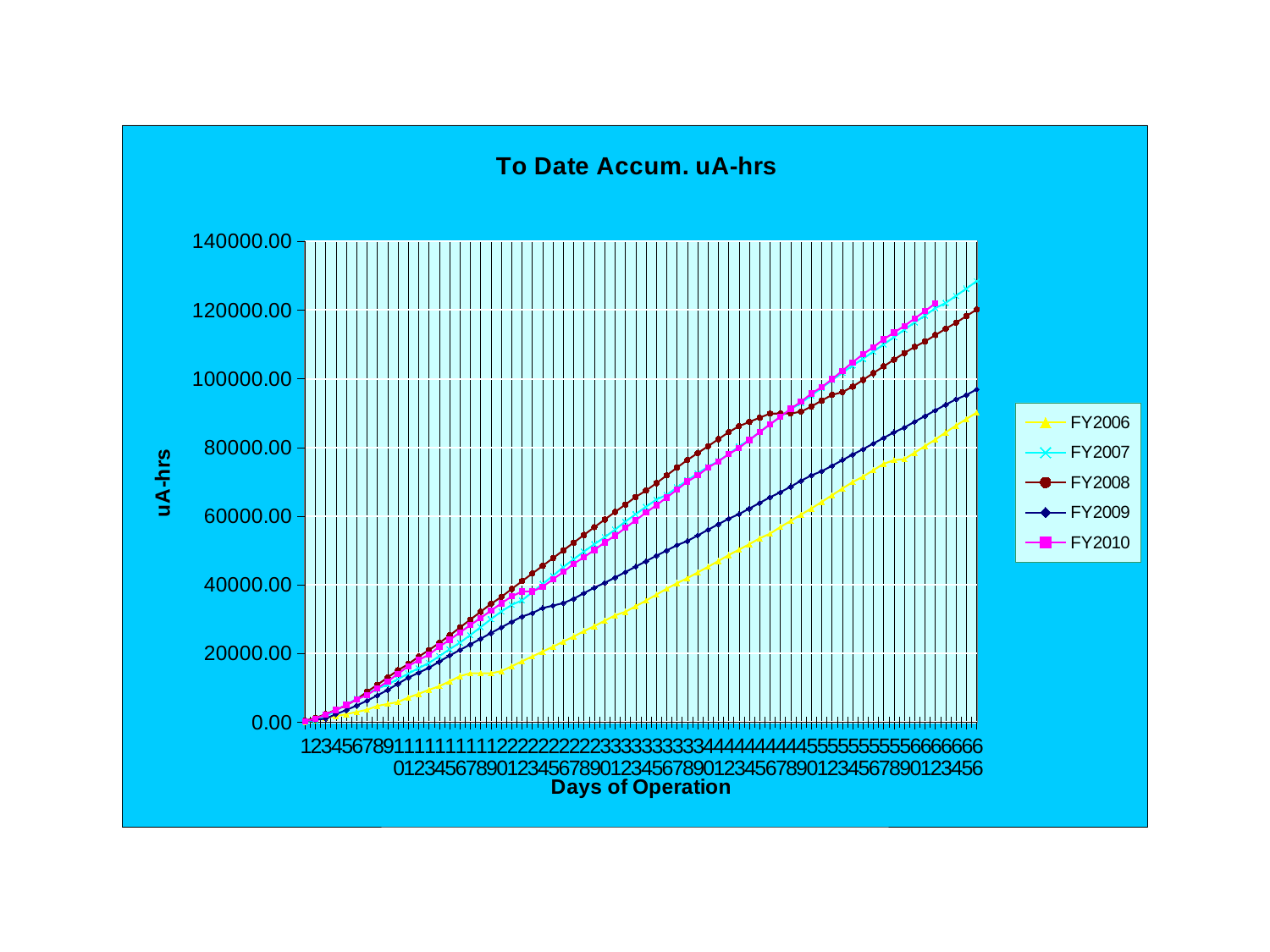
At the final day of operation, is the value for FY2007 greater or less than 120000.00? greater At the final day of operation, which is larger, the value for FY2008 or the value for FY2009? FY2008 How many series does the legend list? 5 At the final day of operation, is the value for FY2009 greater or less than 80000.00? greater Do the values for FY2008 rise or fall as the days of operation increase? rise At the final day of operation, which is larger, the value for FY2007 or the value for FY2006? FY2007 Which series has the lowest value at the last day of operation shown? FY2006 What is the title of the chart? To Date Accum. uA-hrs What kind of chart is shown on the slide? line chart At the final day of operation, is the value for FY2006 greater or less than 100000.00? less Which series has the highest value at the last day of operation shown? FY2007 What is the label of the x axis? Days of Operation